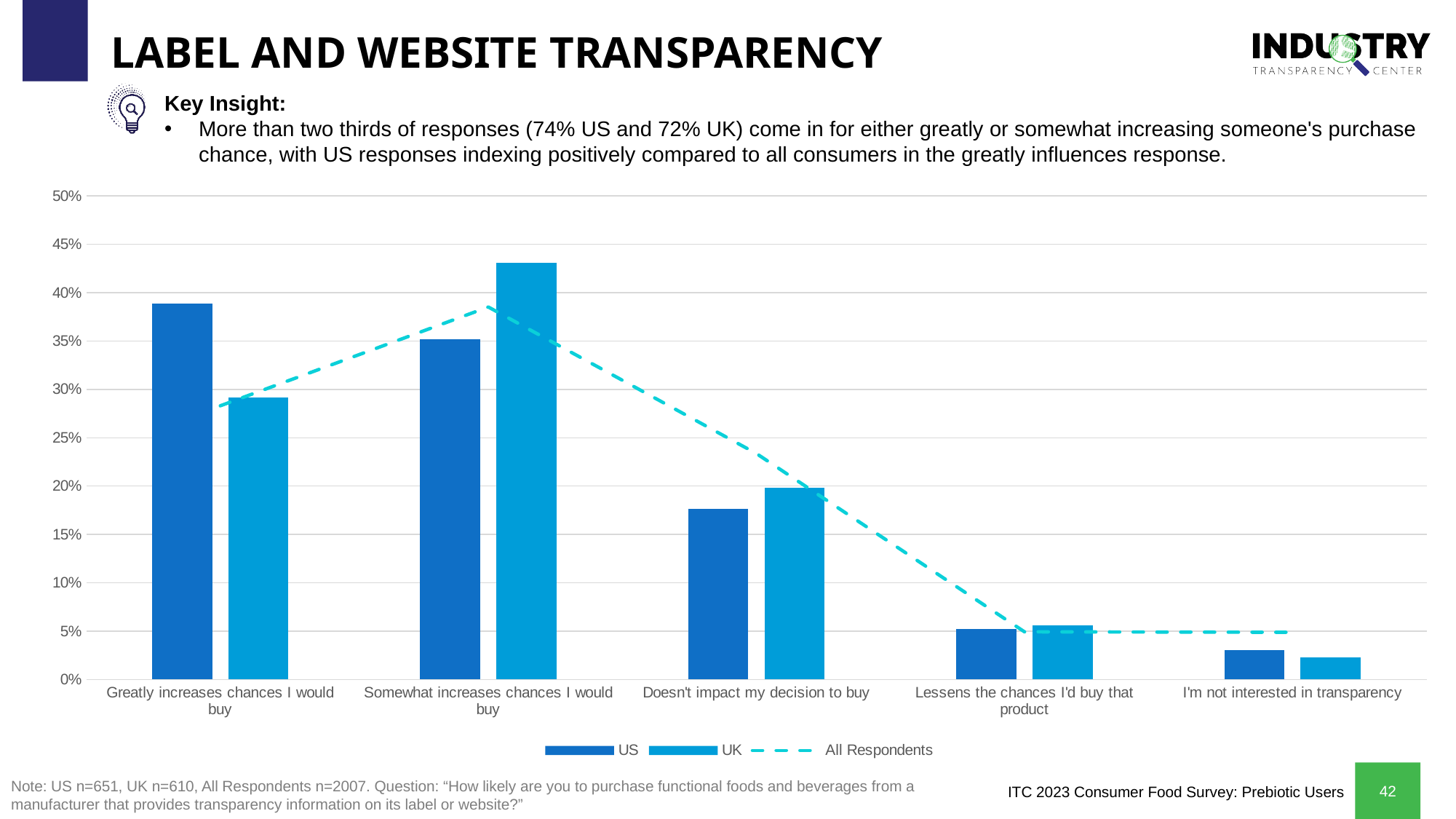
What kind of chart is shown on the slide? combination bar and line chart Which category has the highest US value? Greatly increases chances I would buy Which category has the highest UK value? Somewhat increases chances I would buy For 'Somewhat increases chances I would buy', which is larger, the US or the UK value? UK Is the US value for 'Doesn't impact my decision to buy' greater or less than 20%? less Which category has the lowest US value? I'm not interested in transparency Is the UK value for 'Somewhat increases chances I would buy' greater or less than 40%? greater For 'Greatly increases chances I would buy', which is larger, the US or the UK value? US How many response categories are shown on the x axis? 5 Which series is drawn as a dashed line rather than bars? All Respondents Do the US values rise or fall across the categories from left to right? fall How many series does the legend list? 3